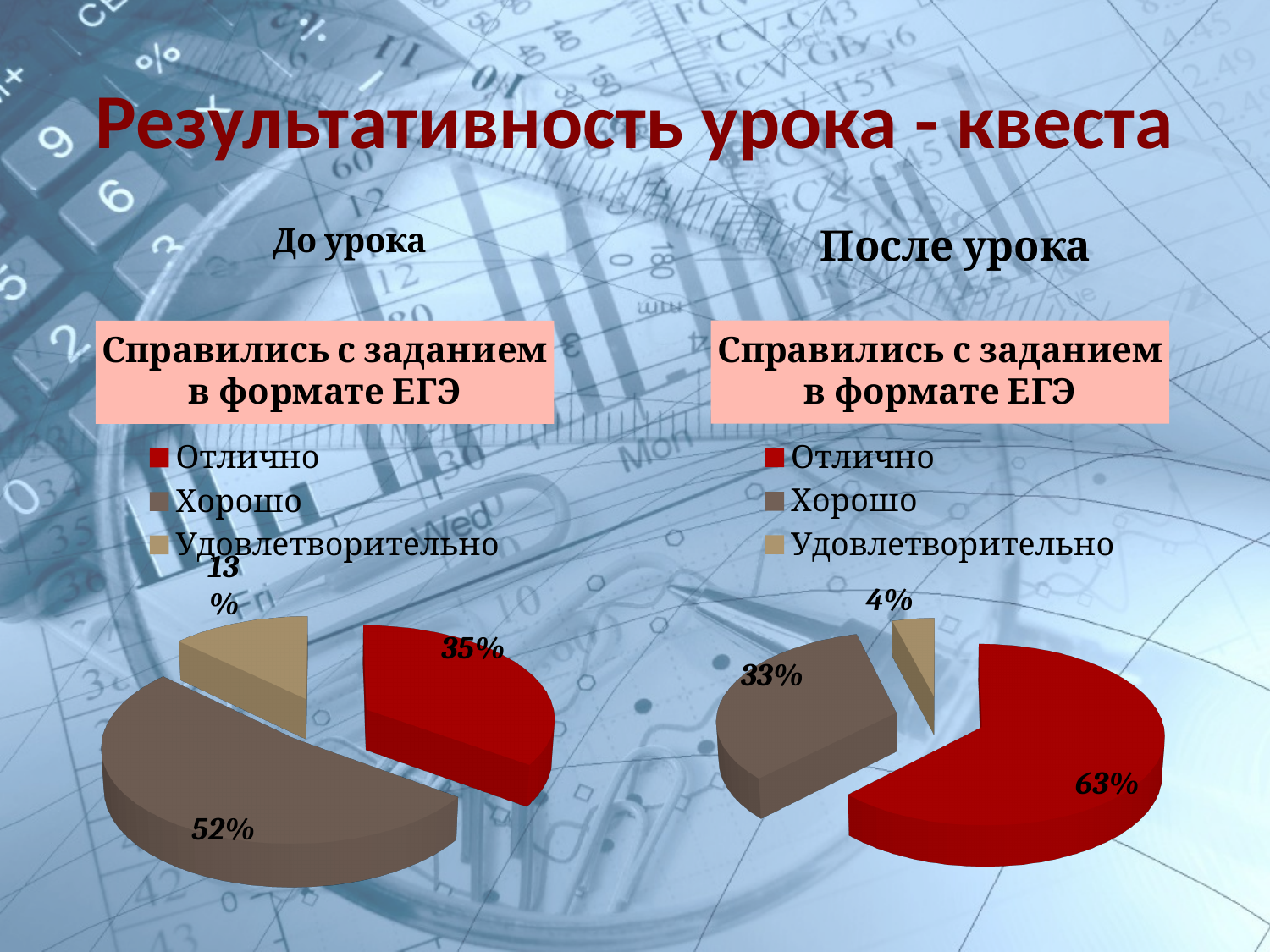
In the "После урока" chart, what share is labelled for Отлично? 63% In the "После урока" chart, what share is labelled for Удовлетворительно? 4% What kind of chart is the "До урока" chart? Pie chart In the "До урока" chart, what share is labelled for Хорошо? 52% In the "До урока" chart, what share is labelled for Отлично? 35% What is the title shown above the "До урока" pie chart? Справились с заданием в формате ЕГЭ How many categories does the legend of the "После урока" chart list? 3 In the "После урока" chart, which category has the largest slice? Отлично In the "После урока" chart, which is larger: the Хорошо slice or the Удовлетворительно slice? Хорошо In the "До урока" chart, which category has the smallest slice? Удовлетворительно What is the difference between the Отлично share in the "После урока" chart and the Отлично share in the "До урока" chart? 28% In the "До урока" chart, what share is labelled for Удовлетворительно? 13%